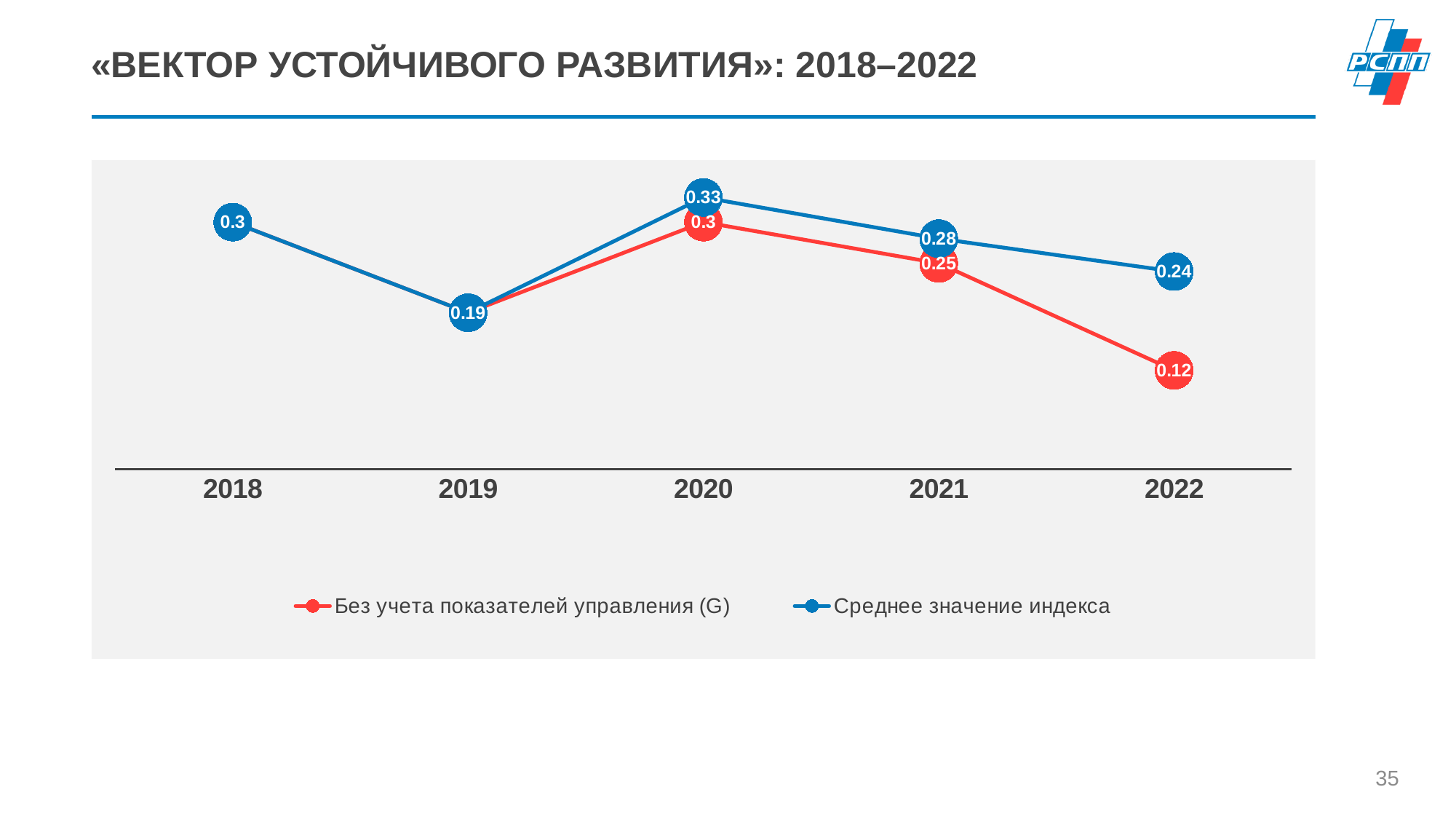
What is the value of the 'Без учета показателей управления (G)' series in 2022? 0.12 In which year is the 'Среднее значение индекса' series highest? 2020 Does the 'Без учета показателей управления (G)' series rise or fall from 2020 to 2022? Fall What is the value of the 'Без учета показателей управления (G)' series in 2021? 0.25 What kind of chart is shown on the slide? Line chart In which year is the 'Среднее значение индекса' series lowest? 2019 How many years are shown on the x axis? 5 How many series does the legend list? 2 What is the value of the 'Среднее значение индекса' series in 2020? 0.33 What is the value of the 'Среднее значение индекса' series in 2019? 0.19 Which series has the larger value in 2021, 'Среднее значение индекса' or 'Без учета показателей управления (G)'? Среднее значение индекса What is the difference between the 'Среднее значение индекса' and 'Без учета показателей управления (G)' values in 2022? 0.12